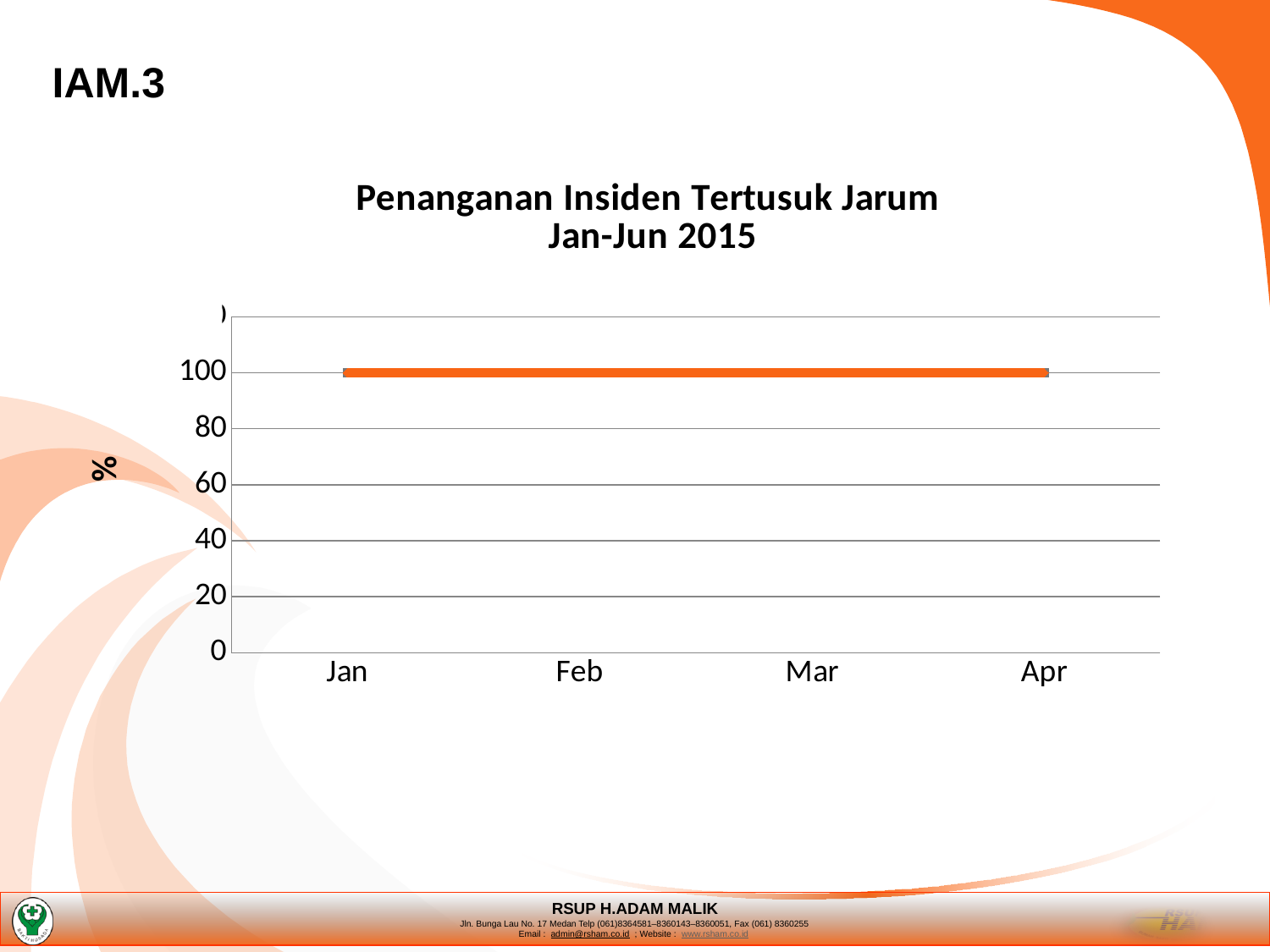
What is the value for Feb in the chart? 100 What is the difference between the values for Jan and Apr? 0 What is the value for Jan in the chart? 100 What is the title of the chart? Penanganan Insiden Tertusuk Jarum Jan-Jun 2015 What is the value for Apr in the chart? 100 What is the highest value shown on the vertical axis tick labels? 100 Do the values rise, fall, or stay constant from Jan to Apr? stay constant Is the value for Feb greater or less than 60? greater How many months are shown on the x axis of the chart? 4 What kind of chart is shown on the slide? line chart Is the value for Mar greater or less than 80? greater What is the label on the vertical axis of the chart? %